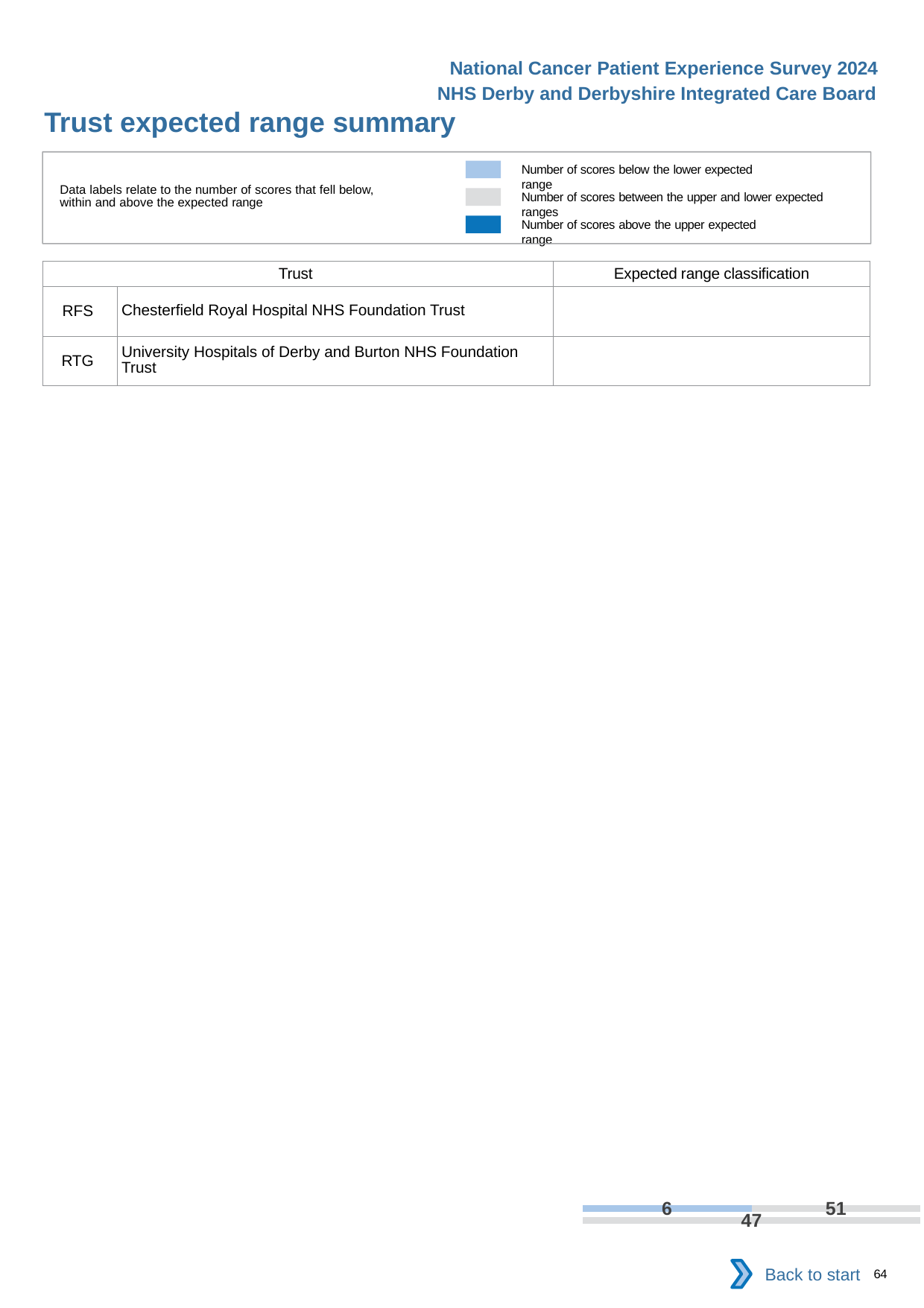
According to the legend, what does the dark blue colour represent? Number of scores above the upper expected range In the chart at the bottom of the slide, what is the difference between the grey segment of the top bar (51) and the value on the bottom bar (47)? 4 How many bars are shown in the chart at the bottom of the slide? 2 According to the legend, what does the light blue colour represent? Number of scores below the lower expected range What kind of chart is shown at the bottom of the slide? bar chart In the chart at the bottom of the slide, what is the value of the grey segment of the top bar? 51 In the chart at the bottom of the slide, what is the difference between the two labelled segments of the top bar (51 and 6)? 45 In the chart at the bottom of the slide, what is the total of the top bar's labelled segments (6 and 51)? 57 In the chart at the bottom of the slide, which is larger: the grey segment of the top bar or the value labelled on the bottom bar? the grey segment of the top bar How many entries does the legend at the top of the slide list? 3 In the chart at the bottom of the slide, what is the value of the light blue segment of the top bar? 6 In the chart at the bottom of the slide, what value is labelled on the bottom bar? 47